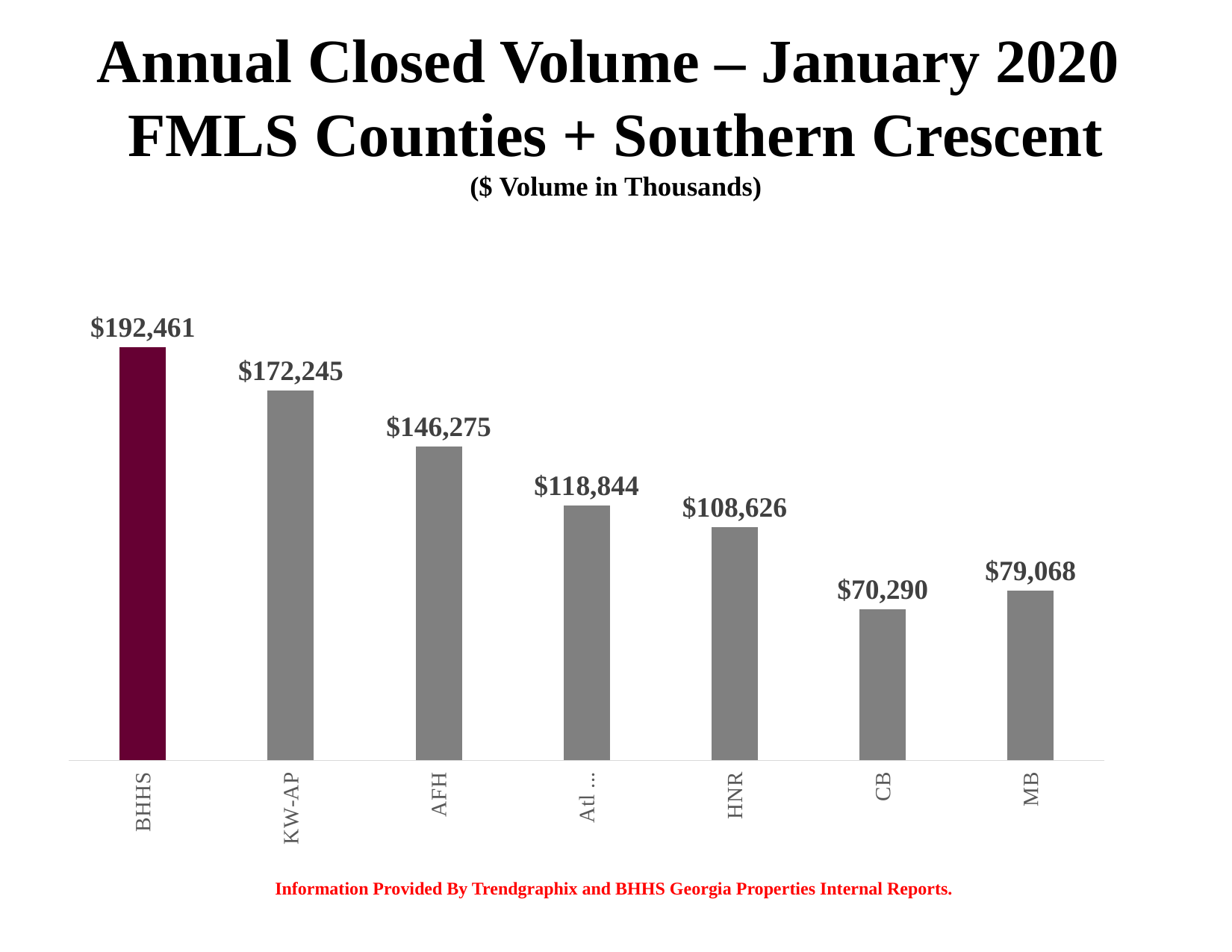
What is the annual closed volume for MB? $79,068 Which company has the highest annual closed volume? BHHS Which has a larger annual closed volume, AFH or HNR? AFH How many companies are shown in the chart? 7 What is the difference between the annual closed volume of BHHS and KW-AP? $20,216 What unit is the volume expressed in, according to the subtitle? $ Volume in Thousands What is the annual closed volume for HNR? $108,626 What type of chart is shown on the slide? Bar chart What is the annual closed volume for KW-AP? $172,245 What is the annual closed volume for BHHS? $192,461 Which company has the lowest annual closed volume? CB What is the difference between the annual closed volume of MB and CB? $8,778